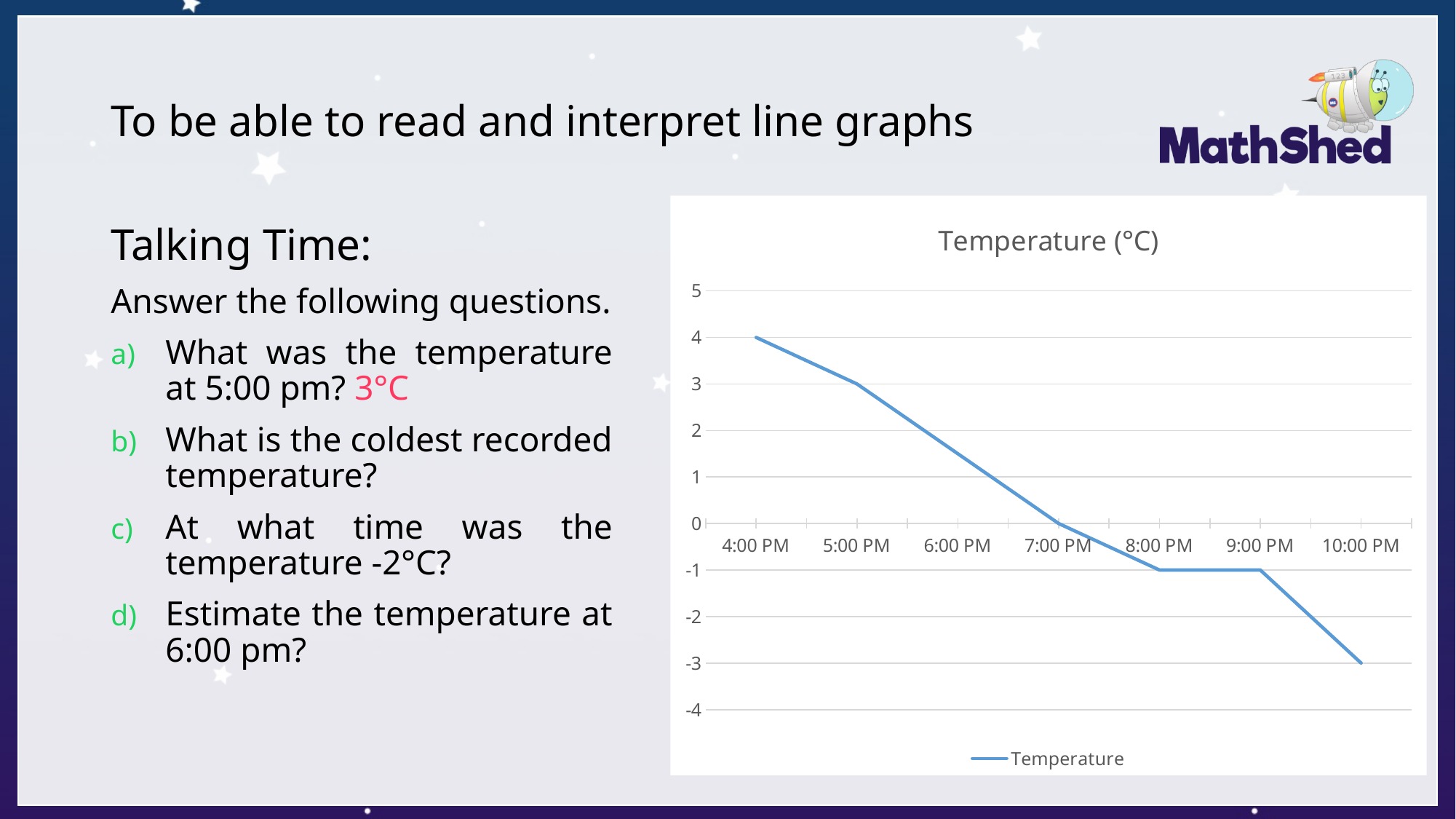
At which time was the temperature lowest? 10:00 PM What was the temperature at 4:00 PM? 4 What is the difference between the temperature at 4:00 PM and at 10:00 PM? 7 What is the title of the chart? Temperature (°C) What was the temperature at 7:00 PM? 0 What was the temperature at 10:00 PM? -3 How many series does the legend list? 1 What type of chart is shown on the slide? line chart What was the temperature at 5:00 PM? 3 How many time points are plotted on the x axis? 7 At which time was the temperature highest? 4:00 PM Is the temperature at 6:00 PM greater or less than 1? greater